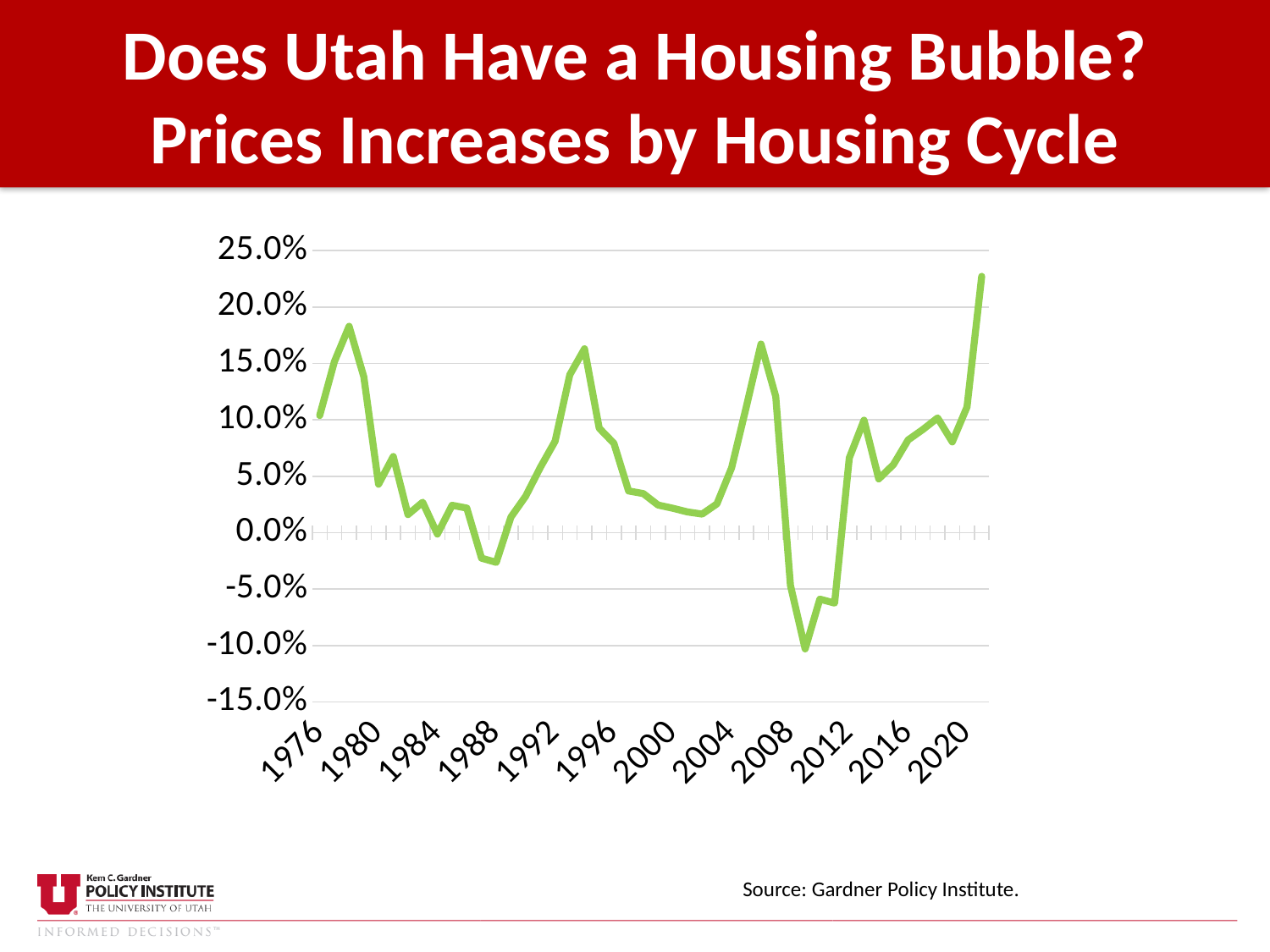
Is the value for 2008 greater or less than 10.0%? less Is the value for 1988 greater or less than 0.0%? less Is the highest value on the chart greater or less than 20.0%? greater Does the line generally rise or fall between 1980 and 1988? fall How many data series are plotted on the chart? 1 Does the line generally rise or fall between 2012 and 2020? rise What kind of chart is shown on the slide? line chart What is the source cited for the chart? Gardner Policy Institute